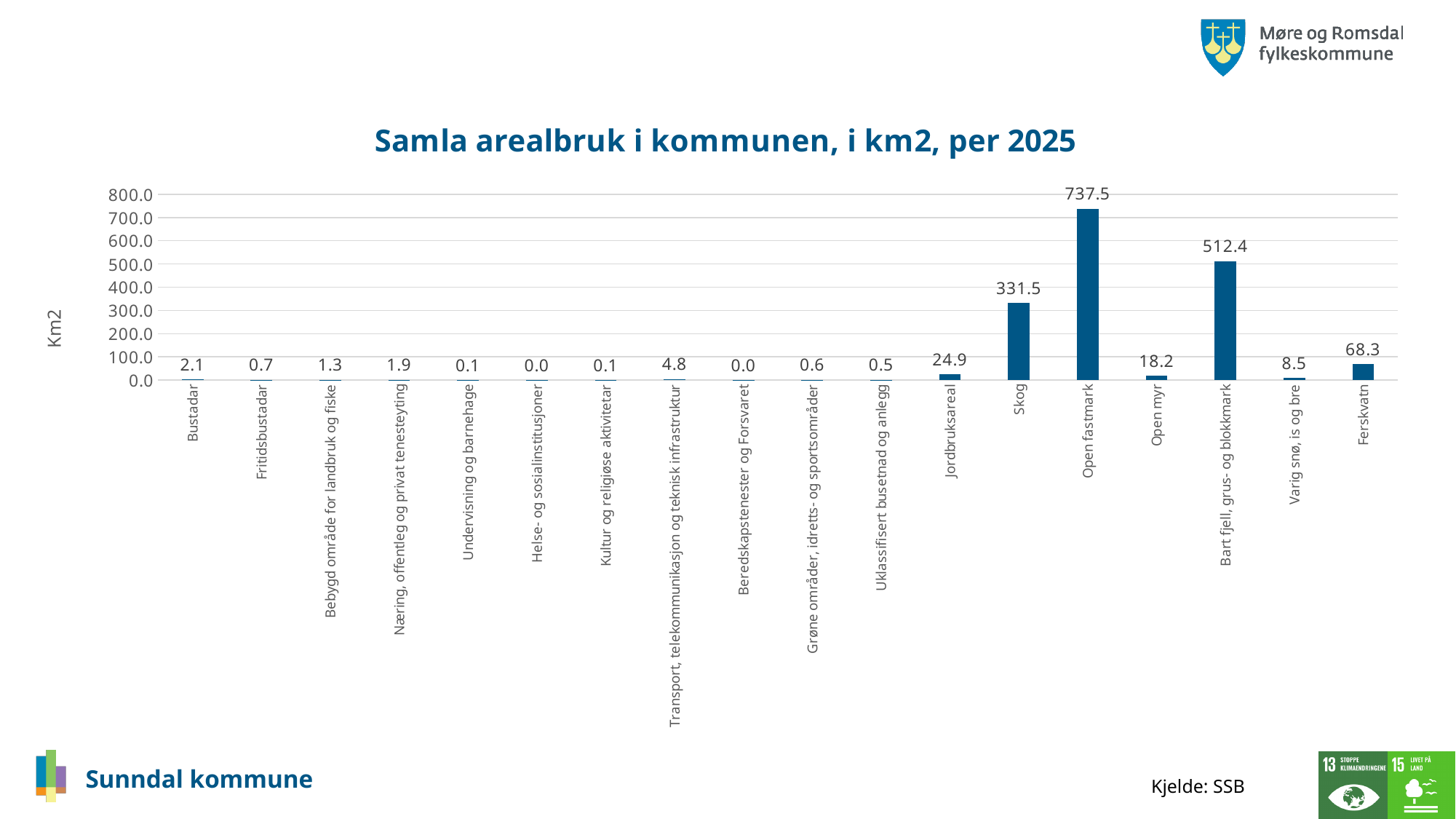
What is the value for Ferskvatn? 68.3 Which category has the highest value? Open fastmark Which is larger, Open myr or Varig snø, is og bre? Open myr What is the value for Jordbruksareal? 24.9 What is the difference between Open fastmark and Bart fjell, grus- og blokkmark? 225.1 What kind of chart is shown? Bar chart What is the difference between Skog and Ferskvatn? 263.2 How many categories are shown on the x axis? 18 What is the title of the chart? Samla arealbruk i kommunen, i km2, per 2025 Is the value for Bart fjell, grus- og blokkmark greater or less than 500.0? greater What is the value for Open fastmark? 737.5 What is the value for Skog? 331.5